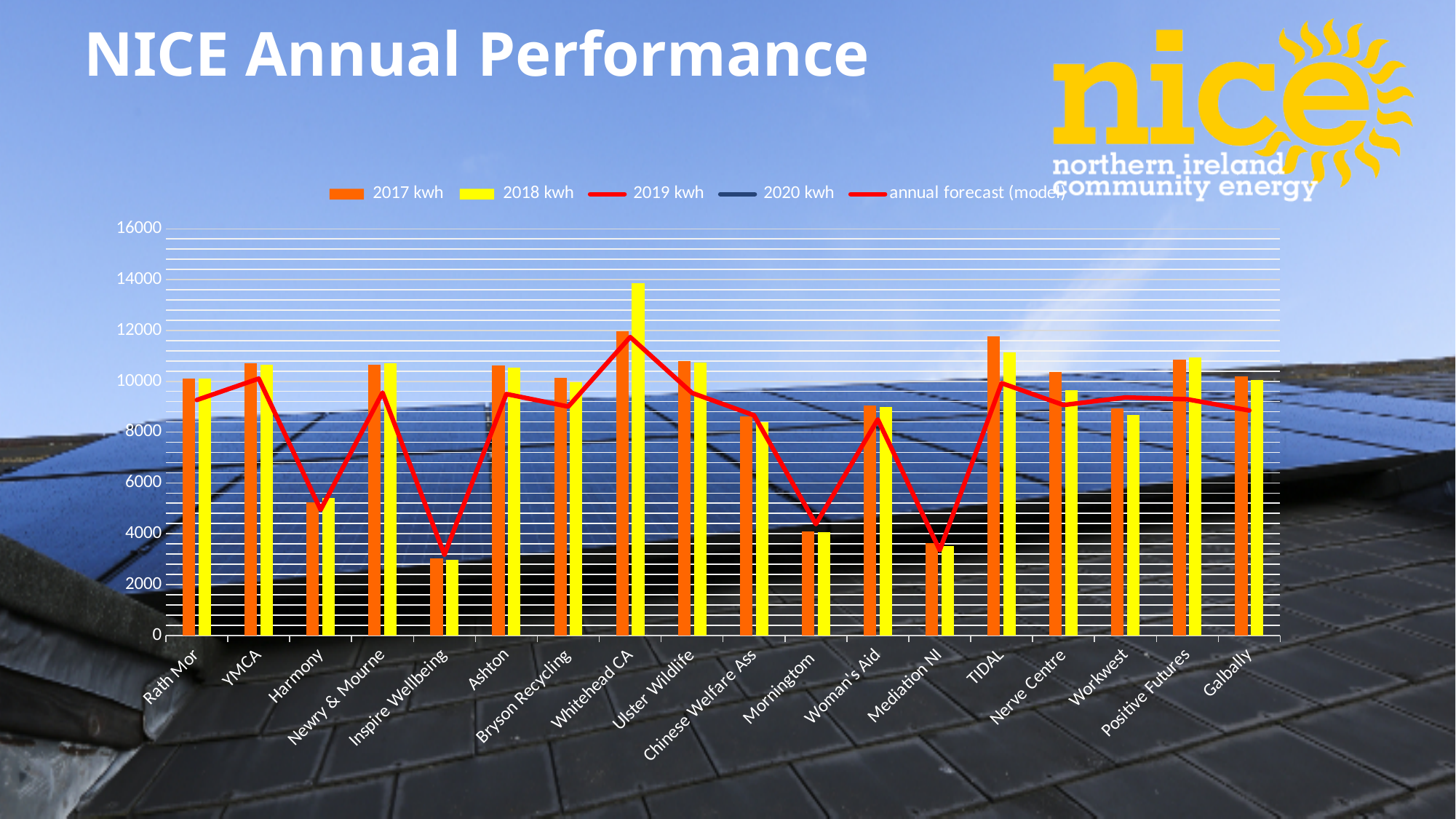
What kind of chart is shown on the slide? A combined bar and line chart Which organisation has the highest 2018 kwh bar? Whitehead CA Is the 2018 kwh value for Inspire Wellbeing greater or less than 4000? less Is the 2017 kwh value for Morningtom greater or less than 6000? less Which is larger, the 2018 kwh value for Whitehead CA or the 2018 kwh value for Ulster Wildlife? Whitehead CA How many series does the chart legend list? 5 Is the 2017 kwh value for Harmony greater or less than 6000? less What is the title of the slide containing the chart? NICE Annual Performance Which is larger, the 2017 kwh value for YMCA or the 2017 kwh value for Harmony? YMCA How many organisations (categories) are shown along the x axis of the chart? 18